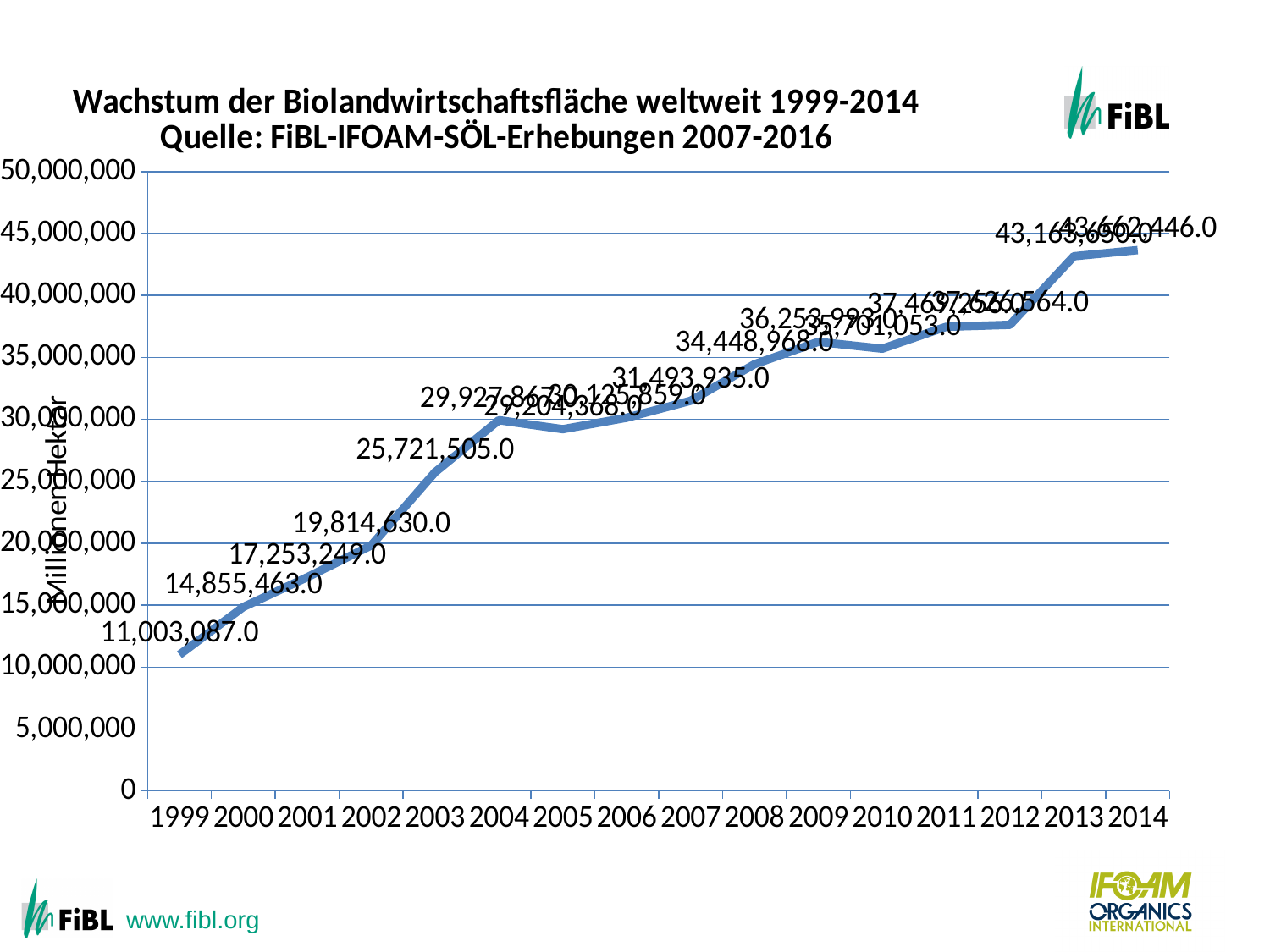
What is the value for 2001? 17,253,249.0 What is the value for 2003? 25,721,505.0 What is the value for 2008? 34,448,968.0 Which year has the lowest value? 1999 What type of chart is shown on the slide? line chart Which is larger, the value for 2009 or the value for 2010? 2009 Which year has the highest value? 2014 How many years are plotted on the x axis? 16 Is the value for 2014 greater or less than 40,000,000? greater What is the value for 1999? 11,003,087.0 What is the difference between the values for 2000 and 1999? 3,852,376.0 What is the difference between the values for 2003 and 2002? 5,906,875.0